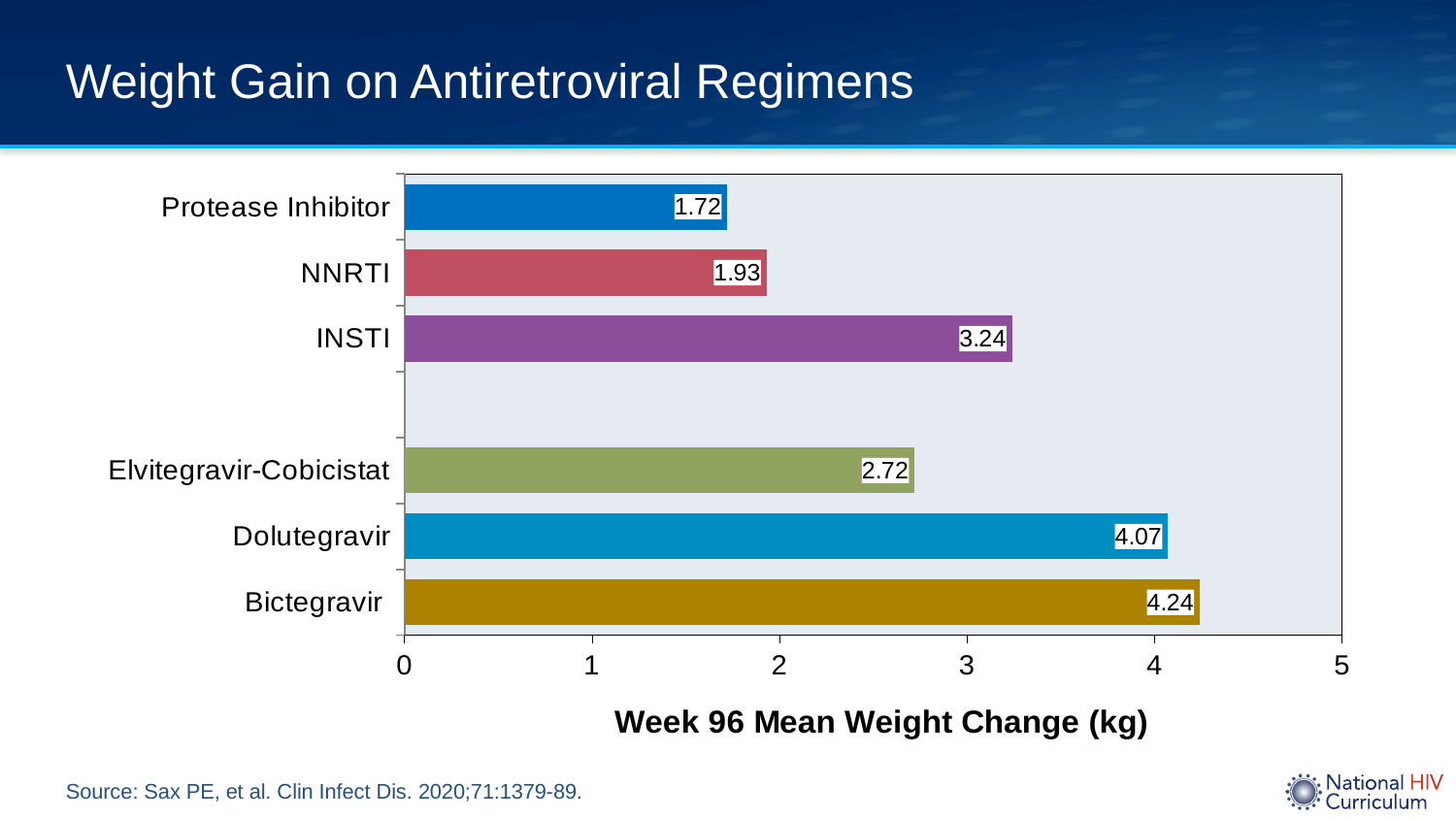
Which has a larger Week 96 mean weight change, INSTI or Elvitegravir-Cobicistat? INSTI What is the Week 96 mean weight change for Protease Inhibitor? 1.72 What is the label of the x axis? Week 96 Mean Weight Change (kg) What kind of chart is shown on the slide? Bar chart Which regimen has the lowest Week 96 mean weight change? Protease Inhibitor How many regimens are plotted on the chart? 6 What is the Week 96 mean weight change for Elvitegravir-Cobicistat? 2.72 Which regimen has the highest Week 96 mean weight change? Bictegravir What is the Week 96 mean weight change for Dolutegravir? 4.07 Is the value for NNRTI greater or less than 2? less What is the difference in Week 96 mean weight change between INSTI and NNRTI? 1.31 What is the difference in Week 96 mean weight change between Bictegravir and Dolutegravir? 0.17